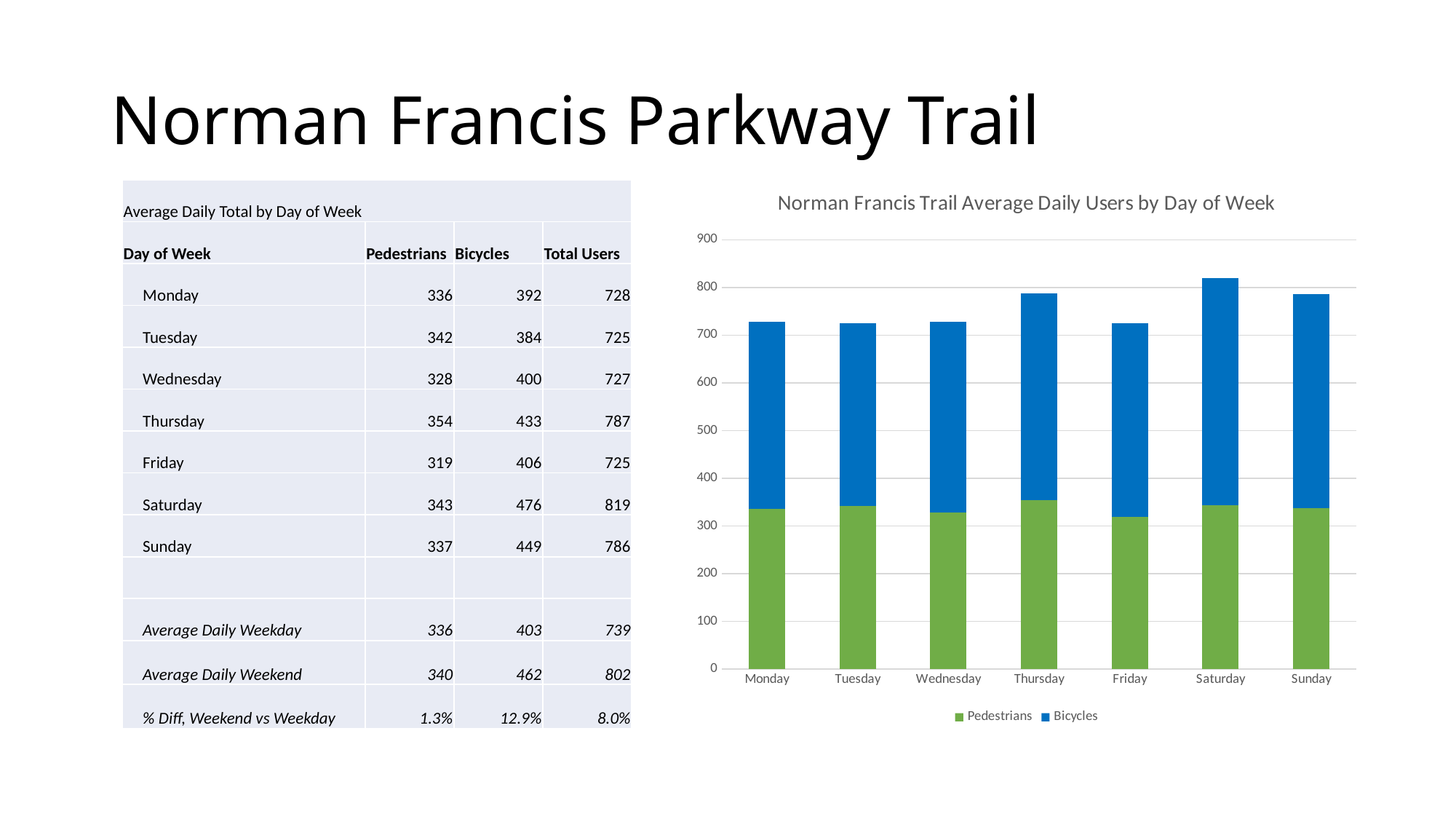
What is the total of the stacked bar for Saturday, as printed in the table? 819 How many days of the week are plotted on the x axis of the chart? 7 Is the total stacked bar for Saturday greater or less than 800? greater Which series is shown in green in the chart? Pedestrians Which day has the highest total stacked bar in the chart? Saturday Is the total stacked bar for Friday greater or less than 800? less What is the title of the chart? Norman Francis Trail Average Daily Users by Day of Week Is the Pedestrians value for Thursday greater or less than 400? less What kind of chart is shown on the slide? Stacked bar chart How many series does the chart legend list? 2 What is the Bicycles value for Sunday, as printed in the table? 449 Is the total stacked bar for Thursday larger or smaller than the total for Wednesday? larger